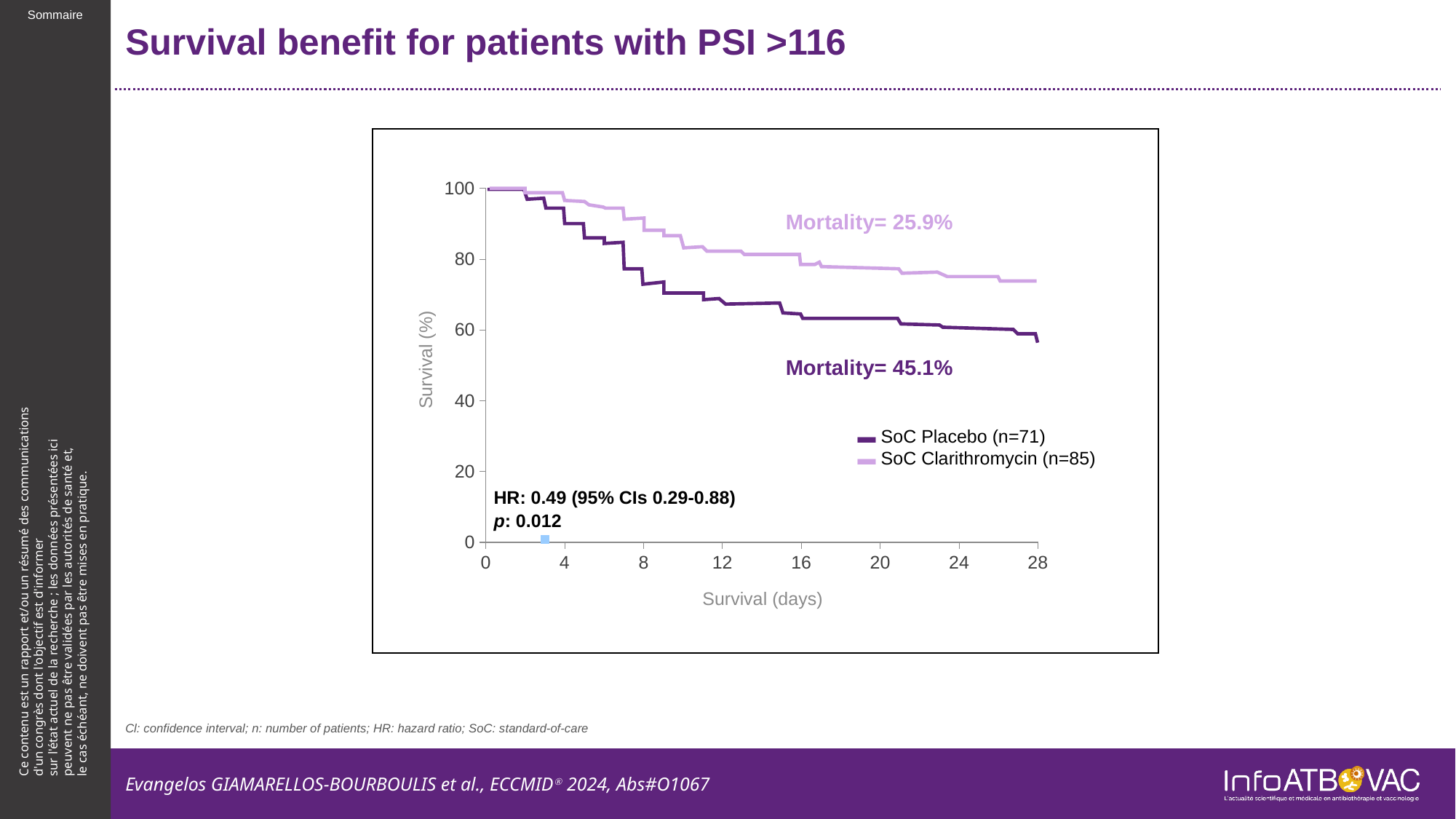
Do the survival curves rise or fall as survival days increase? Fall How many series does the legend list? 2 What is the difference in mortality between the SoC Placebo and SoC Clarithromycin groups? 19.2 percentage points Is the survival for SoC Placebo at day 28 greater or less than 80? less What hazard ratio is printed on the chart? 0.49 (95% CIs 0.29-0.88) What kind of chart is shown on the slide? Line chart What is the mortality reported for the SoC Placebo group? 45.1% Which group has the higher survival at day 28, SoC Placebo or SoC Clarithromycin? SoC Clarithromycin What is the mortality reported for the SoC Clarithromycin group? 25.9% What is the label of the x axis? Survival (days) Is the survival for SoC Clarithromycin at day 28 greater or less than 60? greater How many patients are in the SoC Placebo group according to the legend? 71